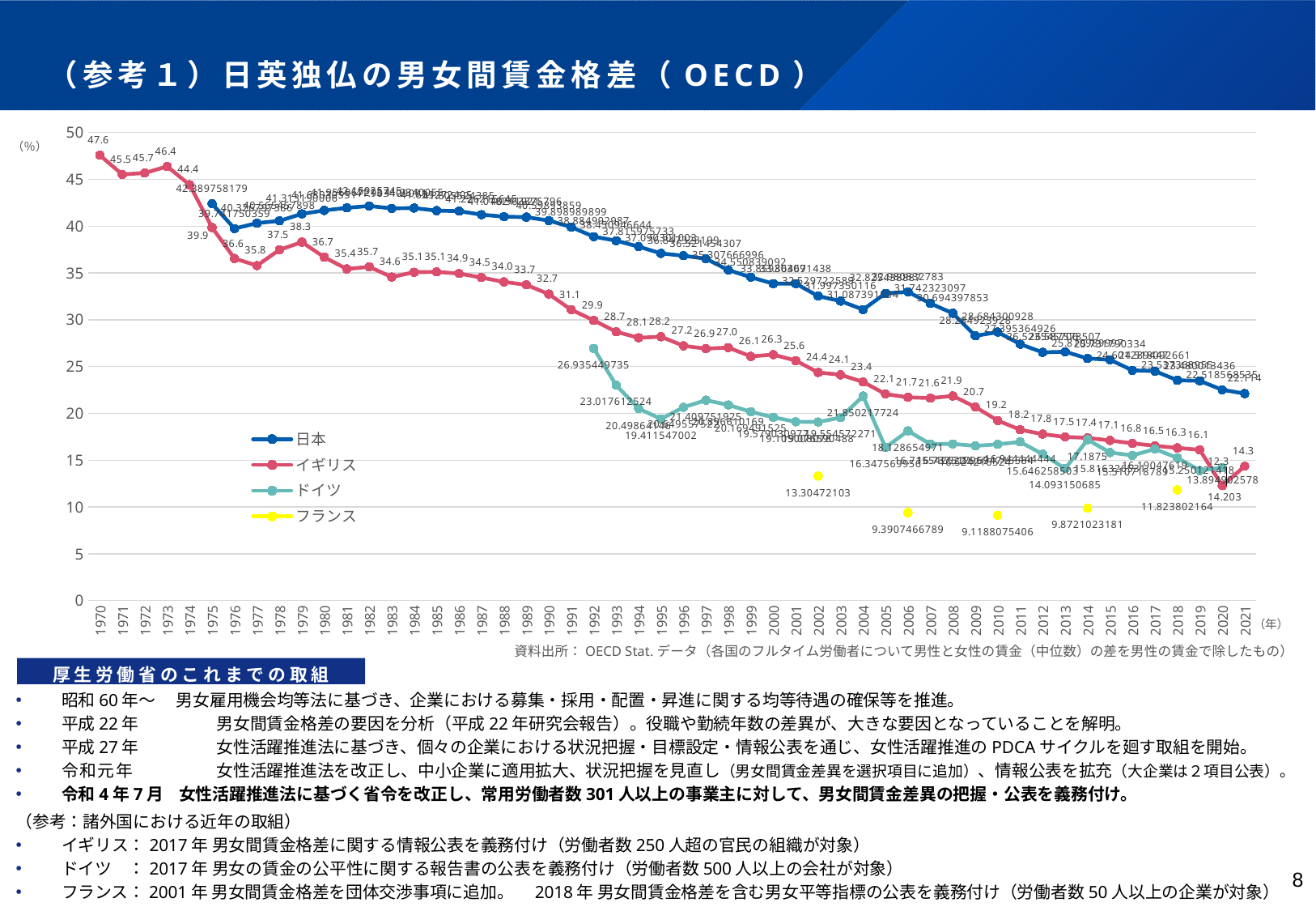
What is the value for イギリス in 1970? 47.6 In which year is the value for フランス lowest? 2010 Which series are listed in the legend? 日本, イギリス, ドイツ, フランス In which year is the value for イギリス highest? 1970 How many series does the legend list? 4 What is the difference between the イギリス values in 1970 and 2021? 33.3 Does the value for イギリス generally rise or fall from 1970 to 2021? fall What kind of chart is shown on the slide? line chart In 2021, which is larger, the value for 日本 or the value for イギリス? 日本 What is the value for フランス in 2010? 9.1188075406 What is the value for イギリス in 2021? 14.3 Is the value for 日本 in 1980 greater or less than 40? greater